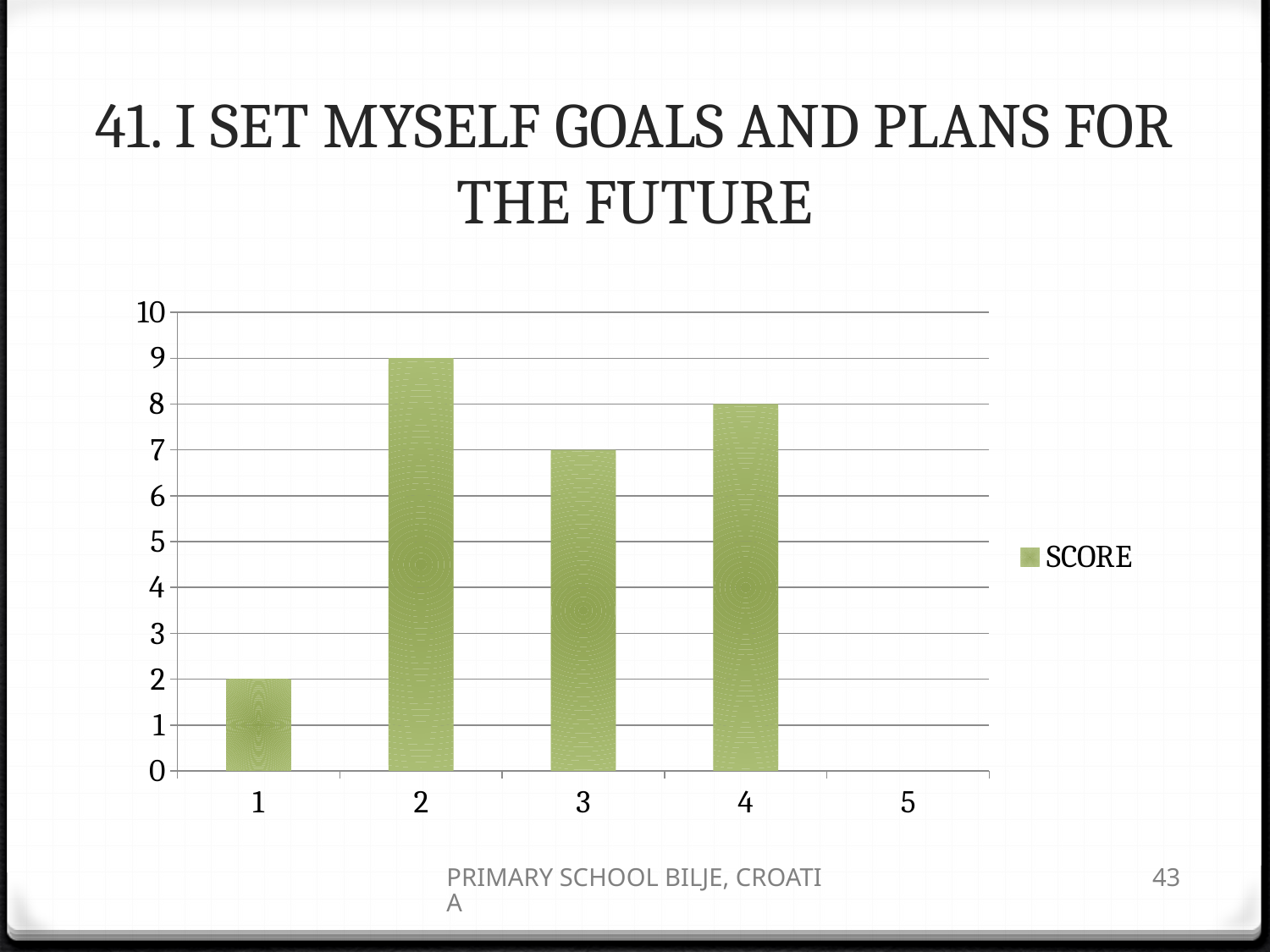
What is the score for category 3? 7 How many series does the legend list? 1 Which category has the tallest bar? 2 What is the score for category 2? 9 Which category has the shortest visible bar? 1 Which has a higher score, category 3 or category 4? 4 What is the score for category 4? 8 What is the difference between the scores for category 2 and category 1? 7 What is the name of the series shown in the legend? SCORE How many categories are shown on the x axis? 5 What type of chart is shown on the slide? bar chart What is the score for category 1? 2